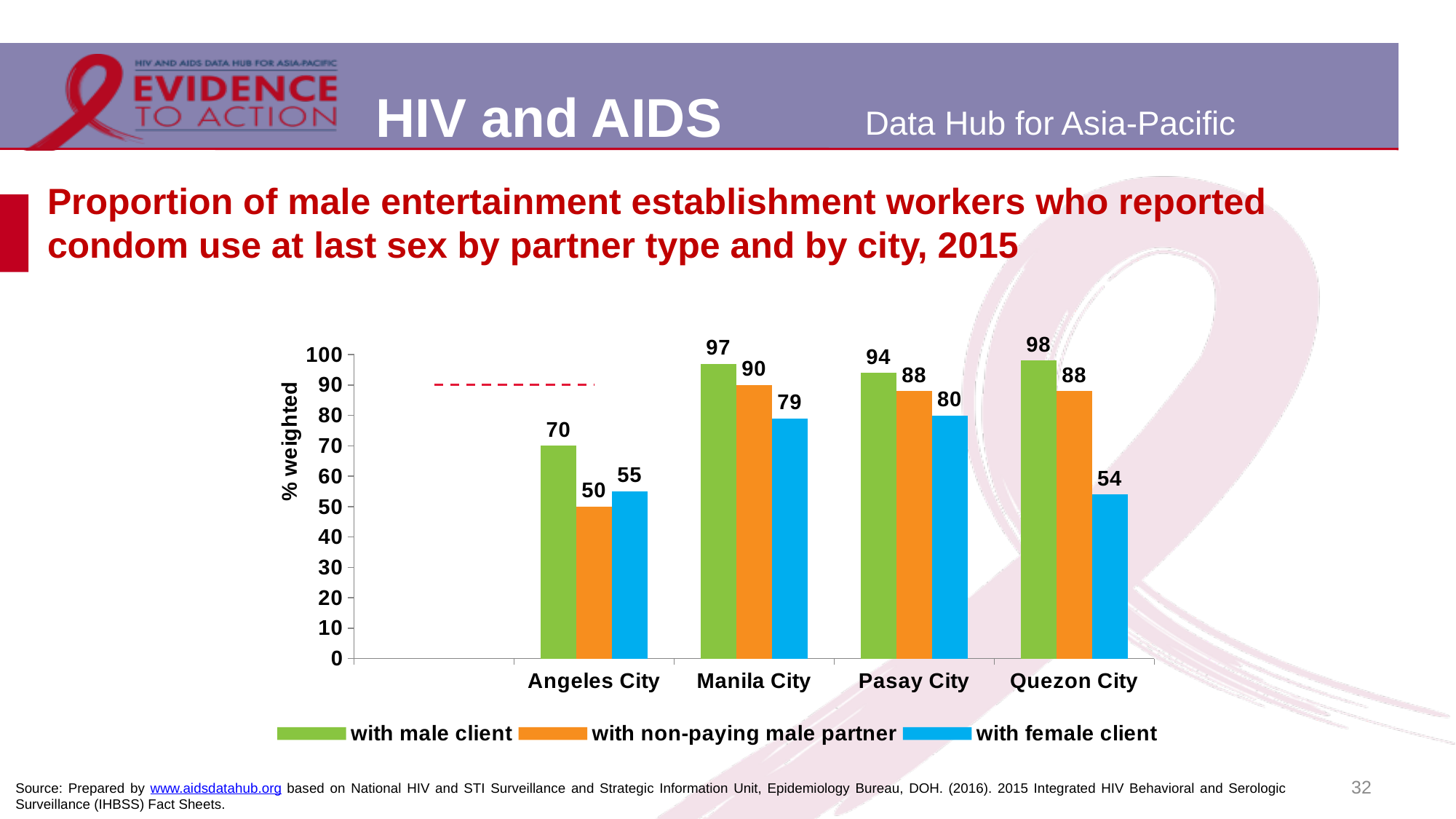
What is the value for 'with non-paying male partner' in Angeles City? 50 Which city has the lowest value for 'with female client'? Quezon City Which city has the highest value for 'with male client'? Quezon City What is the value for 'with male client' in Manila City? 97 What is the value for 'with female client' in Quezon City? 54 What is the label of the y axis? % weighted What kind of chart is shown on the slide? bar chart Which is larger in Pasay City: the value for 'with non-paying male partner' or 'with female client'? with non-paying male partner How many cities are shown on the x axis? 4 How many series does the legend list? 3 What is the difference between the 'with male client' and 'with female client' values in Quezon City? 44 Which colour represents 'with female client' in the legend? blue